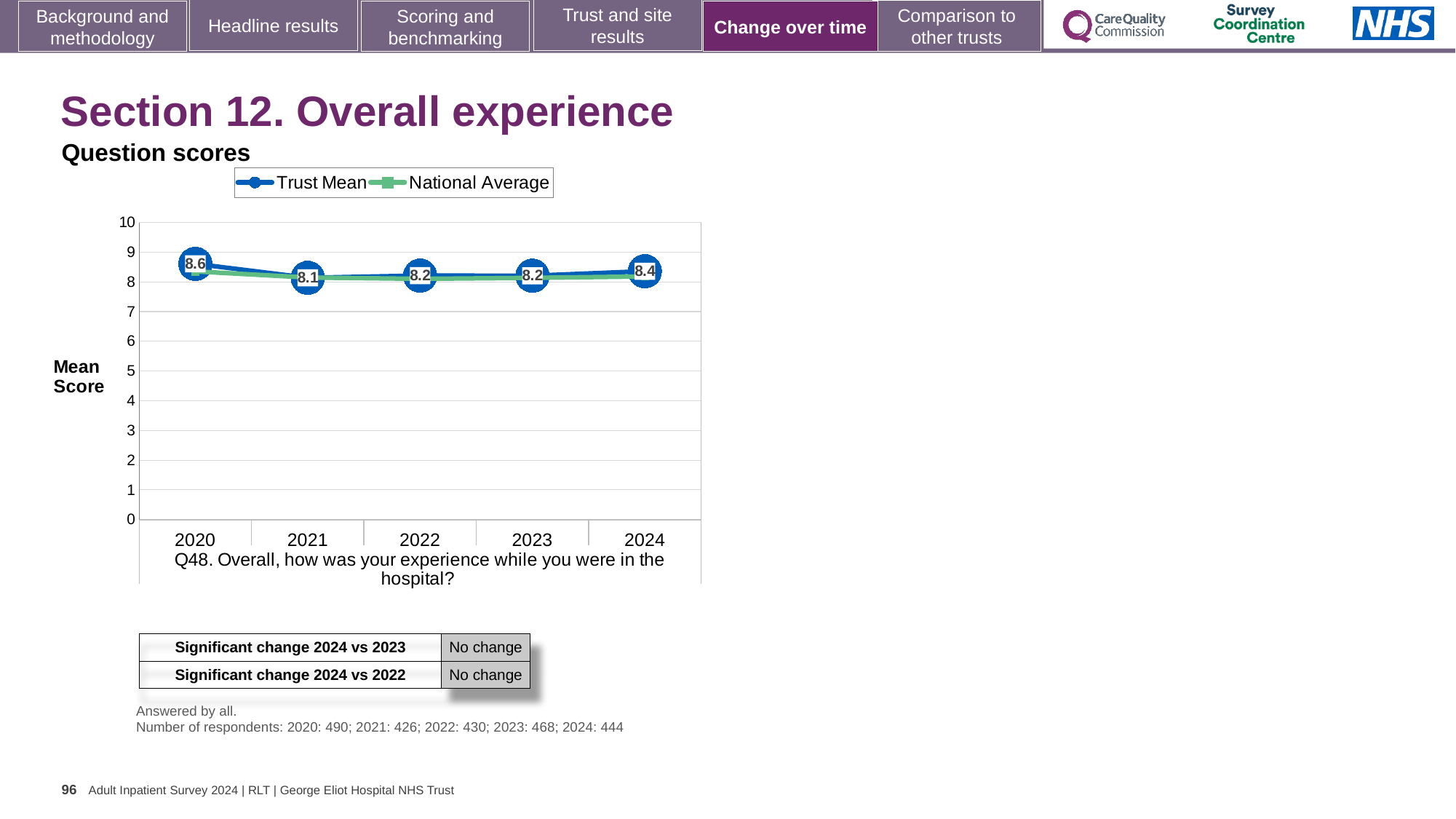
What is the Trust Mean score for 2020? 8.6 Which year has the larger Trust Mean score, 2023 or 2024? 2024 What is the Trust Mean score for 2021? 8.1 Does the Trust Mean score rise or fall from 2020 to 2021? Fall What is the difference between the Trust Mean scores for 2020 and 2021? 0.5 Is the National Average value for 2020 greater or less than 9? less How many series does the legend list? 2 In which year is the Trust Mean score lowest? 2021 In which year is the Trust Mean score highest? 2020 How many years are plotted on the x axis? 5 What kind of chart is shown on the slide? Line chart What is the Trust Mean score for 2024? 8.4